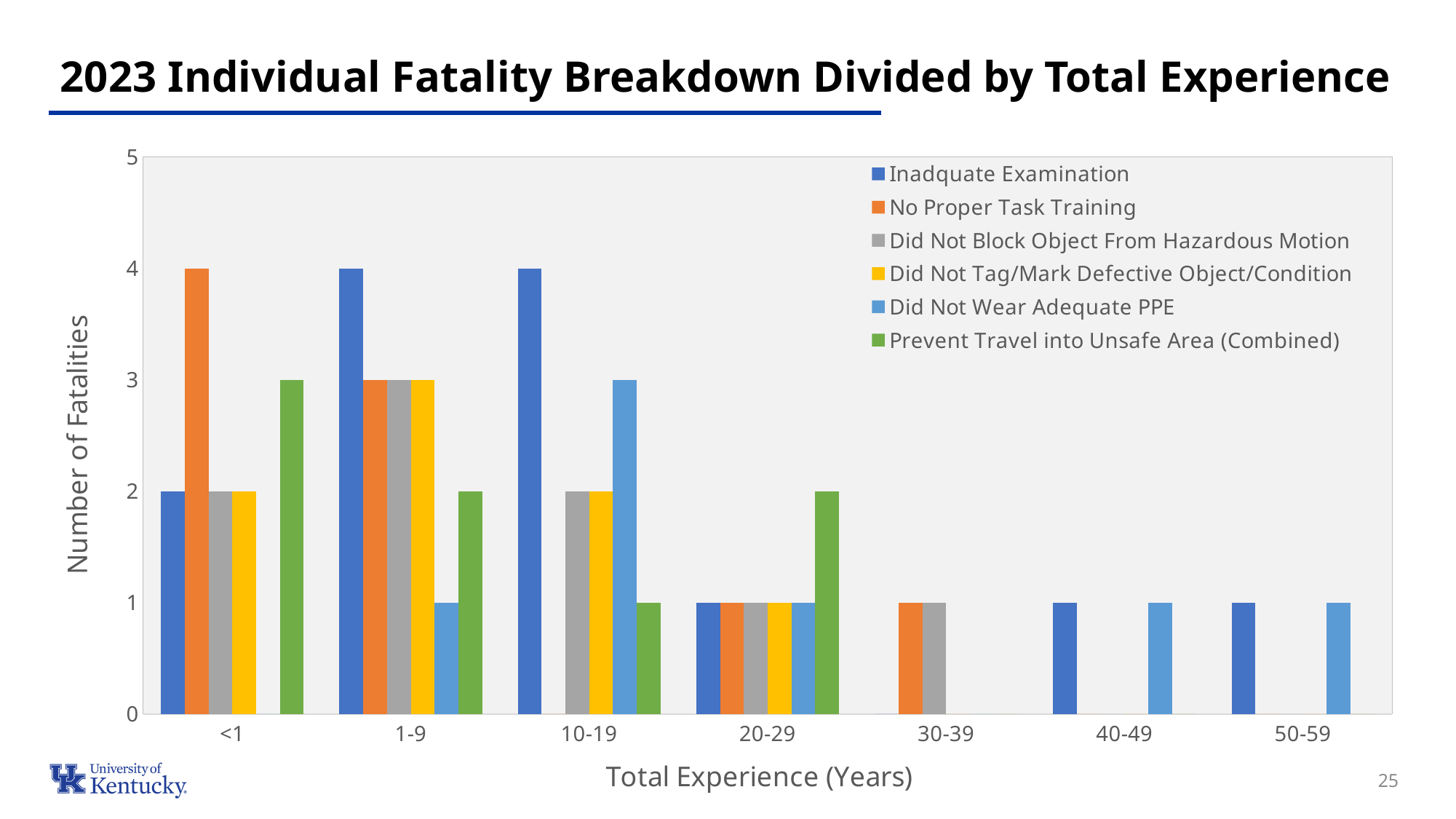
What kind of chart is shown on the slide? Bar chart Which series has the highest value in the <1 years category? No Proper Task Training Does the number of fatalities for Inadquate Examination rise or fall from the 10-19 category to the 20-29 category? Fall Which is larger in the 1-9 years category: Inadquate Examination or Prevent Travel into Unsafe Area (Combined)? Inadquate Examination Which series has the lowest value in the 1-9 years category? Did Not Wear Adequate PPE What is the label of the y axis? Number of Fatalities What is the number of fatalities for Inadquate Examination in the 10-19 years category? 4 What is the number of fatalities for Did Not Wear Adequate PPE in the 1-9 years category? 1 What is the difference between Inadquate Examination and Did Not Wear Adequate PPE in the 10-19 years category? 1 What is the number of fatalities for No Proper Task Training in the <1 years category? 4 How many series does the legend list? 6 How many experience categories are shown on the x axis? 7